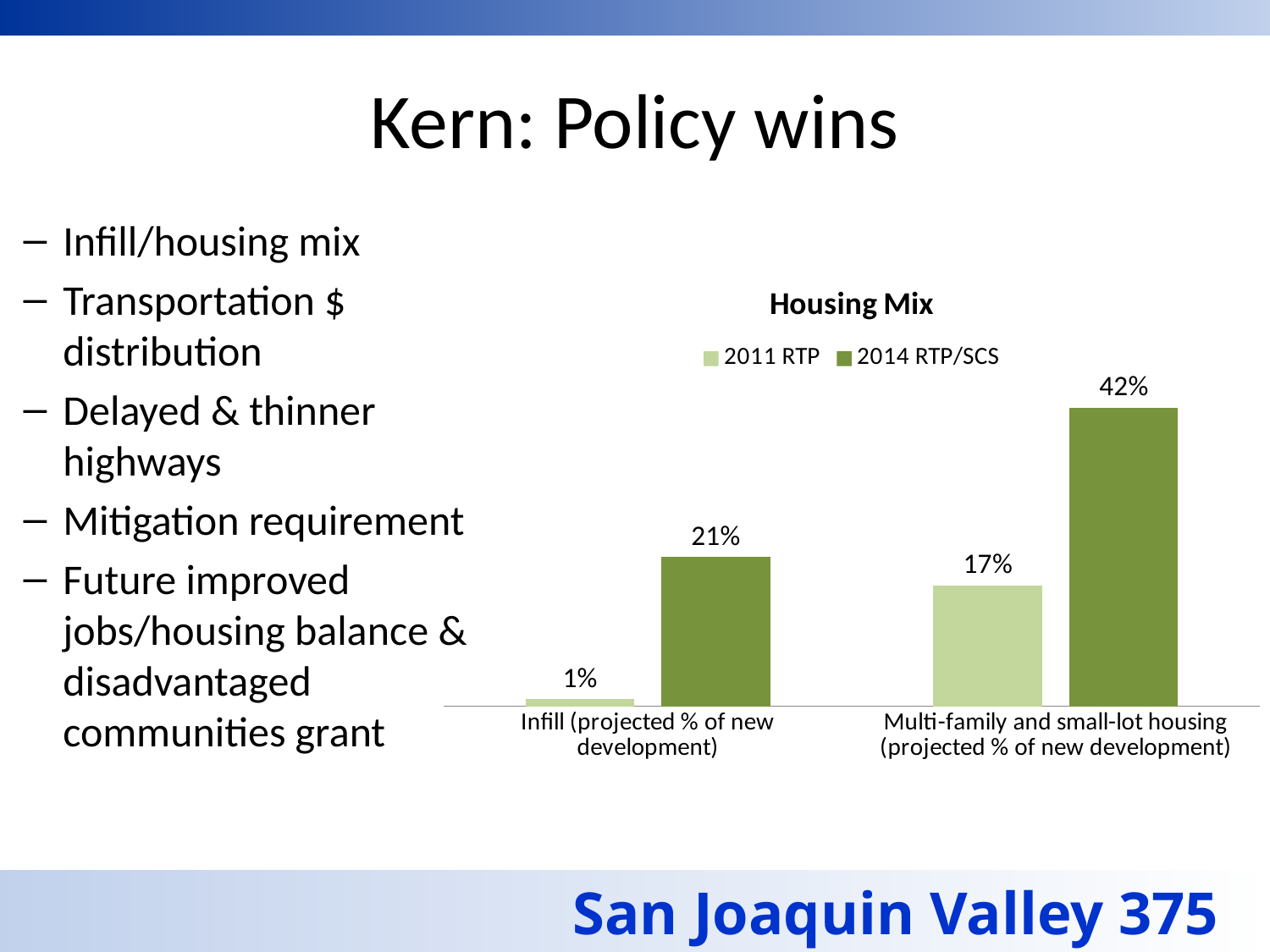
Which bar has the highest value in the chart? 2014 RTP/SCS, Multi-family and small-lot housing How many categories are shown on the x axis? 2 What is the title of the chart? Housing Mix What kind of chart is shown on the slide? bar chart What is the 2011 RTP value for Multi-family and small-lot housing (projected % of new development)? 17% Which is larger for Infill: the 2011 RTP value or the 2014 RTP/SCS value? 2014 RTP/SCS What is the 2014 RTP/SCS value for Infill (projected % of new development)? 21% What is the 2014 RTP/SCS value for Multi-family and small-lot housing (projected % of new development)? 42% Which bar has the lowest value in the chart? 2011 RTP, Infill What is the 2011 RTP value for Infill (projected % of new development)? 1% What is the difference between the 2014 RTP/SCS and 2011 RTP values for Multi-family and small-lot housing? 25% How many series does the legend list? 2